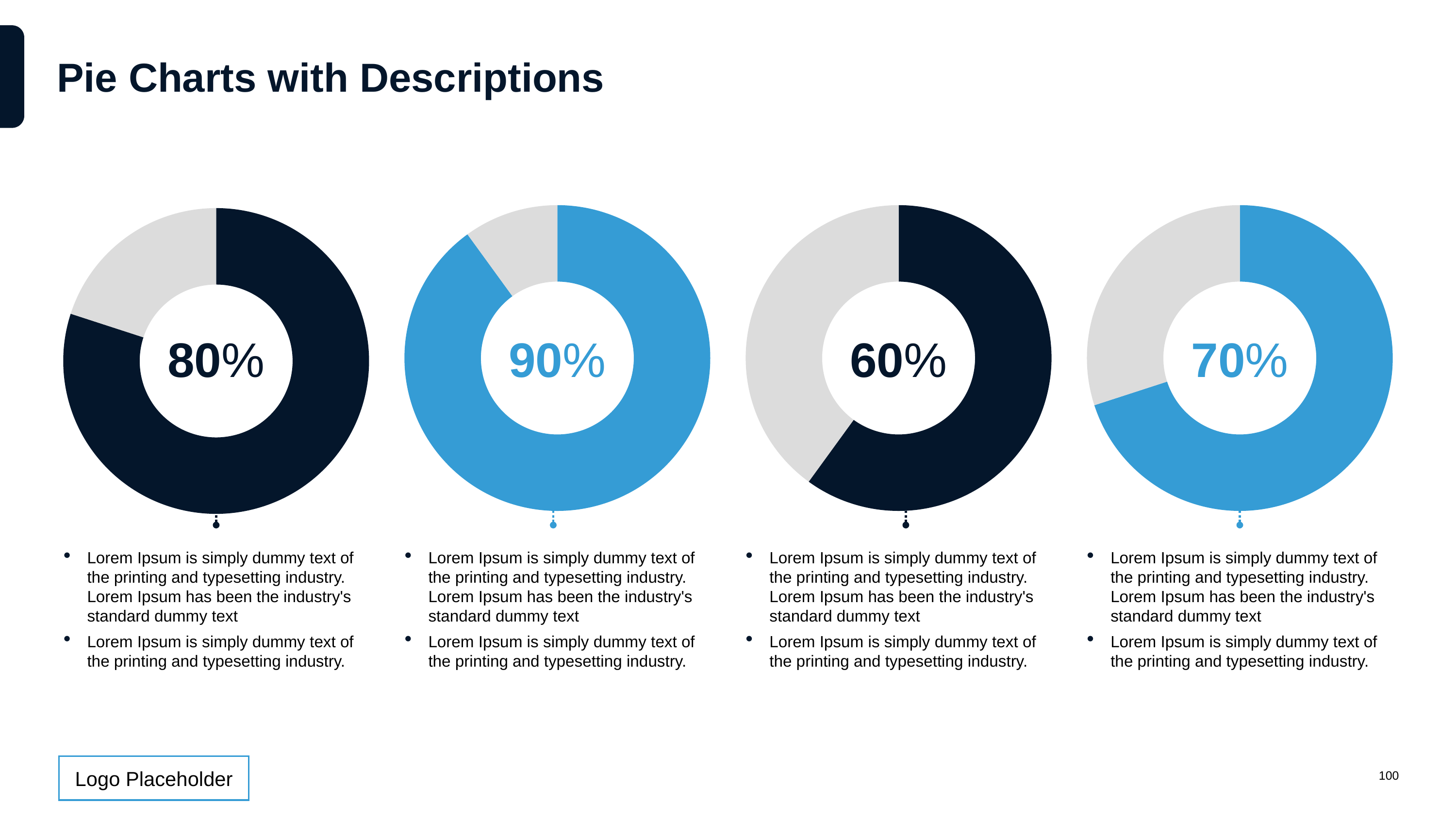
What percentage is shown in the centre of the rightmost donut chart? 70% What is the difference between the percentage in the second donut chart (90%) and the third donut chart (60%)? 30% Which of the four donut charts shows the highest percentage? The second from the left (90%) How many donut charts are shown on the slide? 4 What kind of chart is used on this slide? Donut (pie) chart What percentage is shown in the centre of the third donut chart from the left? 60% What percentage is shown in the centre of the second donut chart from the left? 90% Which is larger: the percentage in the leftmost donut chart or the rightmost donut chart? The leftmost (80%) What percentage is shown in the centre of the leftmost donut chart? 80% What is the title of the slide? Pie Charts with Descriptions Which of the four donut charts shows the lowest percentage? The third from the left (60%) What colour is the filled portion of the second donut chart from the left? Blue